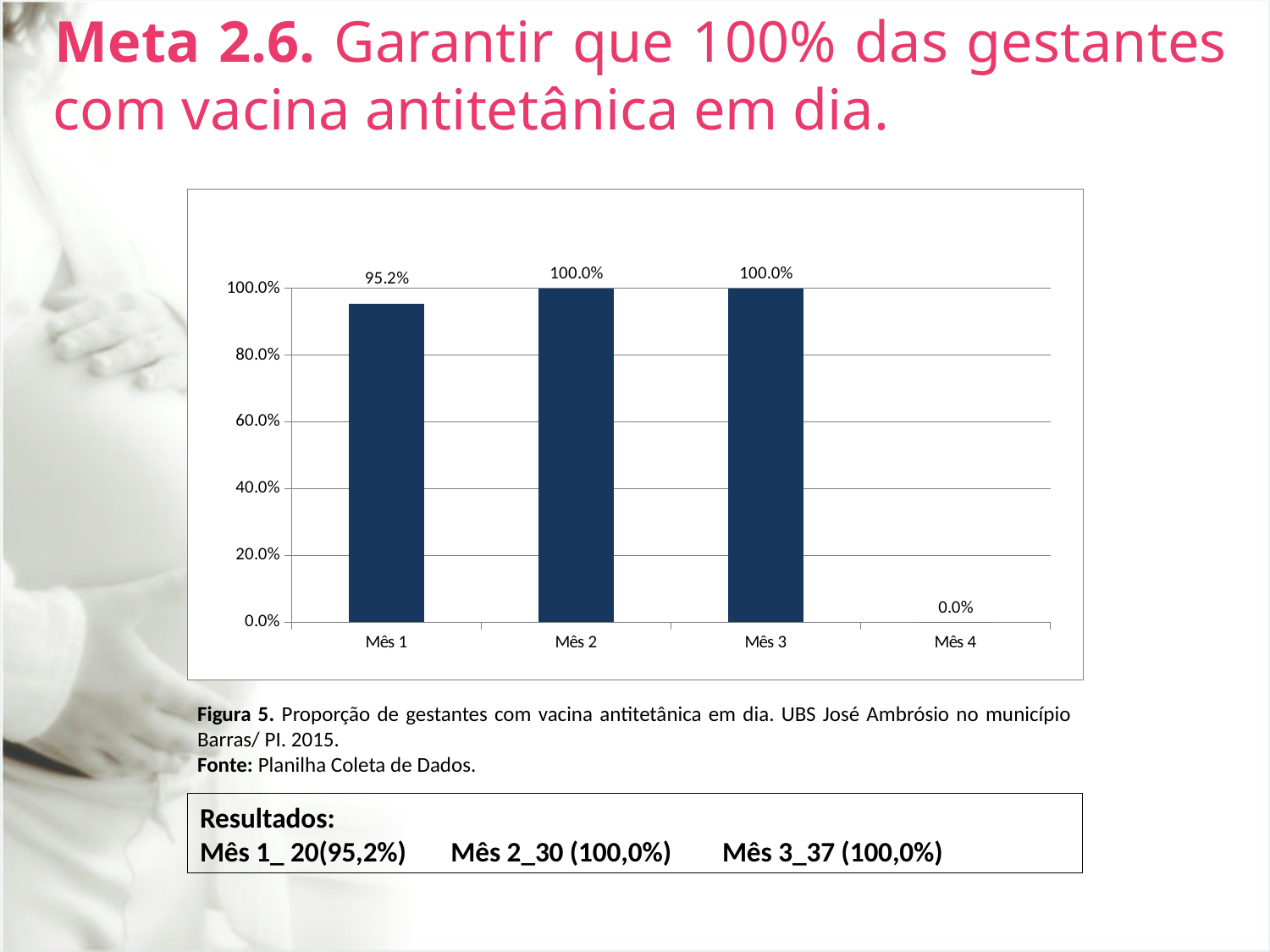
Do the values rise or fall from Mês 3 to Mês 4? fall How many categories are shown on the x axis? 4 What is the difference between the values for Mês 2 and Mês 1? 4.8% What is the value for Mês 2? 100.0% What is the value for Mês 4? 0.0% What colour are the bars in the chart? dark blue Is the value for Mês 1 greater or less than 80.0%? greater Which is larger, the value for Mês 1 or the value for Mês 3? Mês 3 How many categories have a value of 100.0%? 2 Which category has the lowest value? Mês 4 What kind of chart is shown on the slide? bar chart What is the value for Mês 1? 95.2%